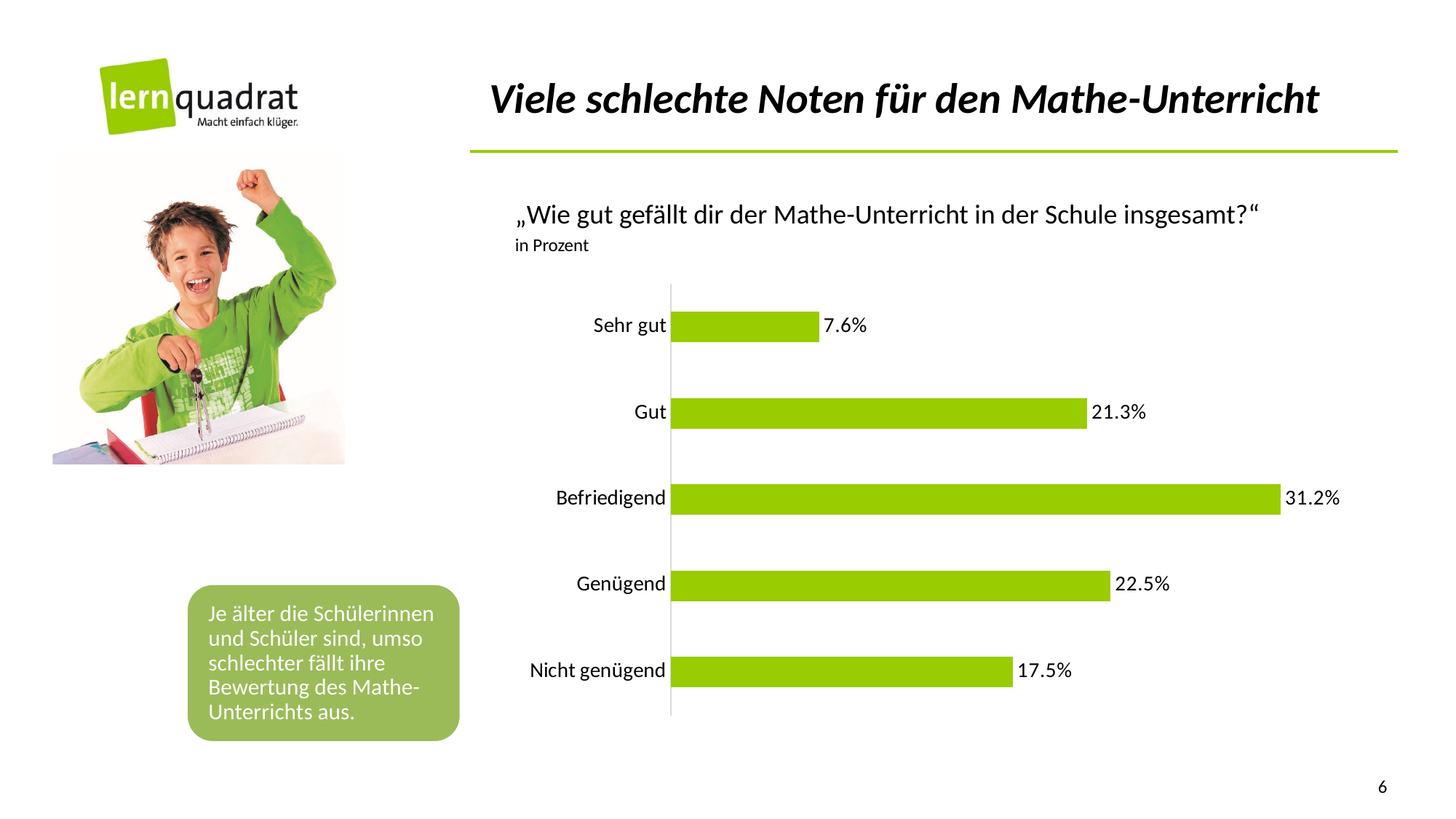
What is the difference between the values for "Befriedigend" and "Nicht genügend"? 13.7% Which category has the lowest value? Sehr gut What kind of chart is shown on the slide? Bar chart How many categories are shown in the chart? 5 What is the value shown for "Befriedigend"? 31.2% What question is the chart based on, as shown above the chart? „Wie gut gefällt dir der Mathe-Unterricht in der Schule insgesamt?“ What percentage is shown for "Nicht genügend"? 17.5% What is the difference between the values for "Genügend" and "Gut"? 1.2% What percentage of students rated the math lessons as "Sehr gut"? 7.6% What colour are the bars in the chart? Green Which category has the highest value? Befriedigend Which is larger, the value for "Gut" or the value for "Nicht genügend"? Gut